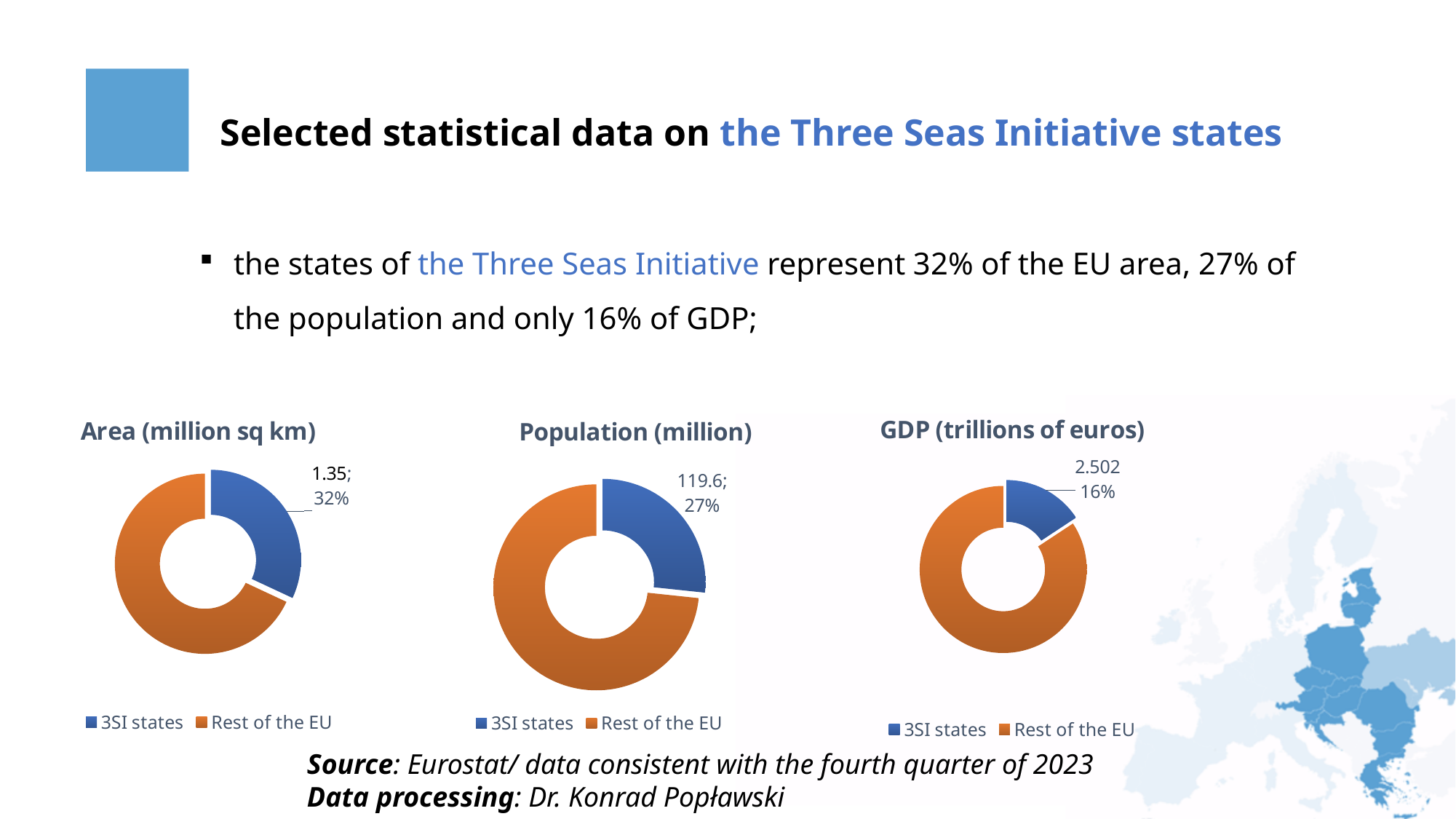
In the 'GDP (trillions of euros)' chart, which slice is larger: 3SI states or Rest of the EU? Rest of the EU In the 'Population (million)' chart, what value is shown for 3SI states? 119.6 In the 'GDP (trillions of euros)' chart, what value is shown for 3SI states? 2.502 In the 'Area (million sq km)' chart, what share of the EU area do the 3SI states represent? 32% In the 'Area (million sq km)' chart, what value is shown for 3SI states? 1.35 How many slices does the 'GDP (trillions of euros)' chart have? 2 In the 'Population (million)' chart, what share of the EU population do the 3SI states represent? 27% In the 'Area (million sq km)' chart, which category has the smallest slice? 3SI states In the 'GDP (trillions of euros)' chart, what share of EU GDP do the 3SI states represent? 16% What kind of chart is the 'Population (million)' chart? Doughnut (pie) chart How many entries does the legend of the 'Area (million sq km)' chart list? 2 What is the title of the chart on the left of the slide? Area (million sq km)